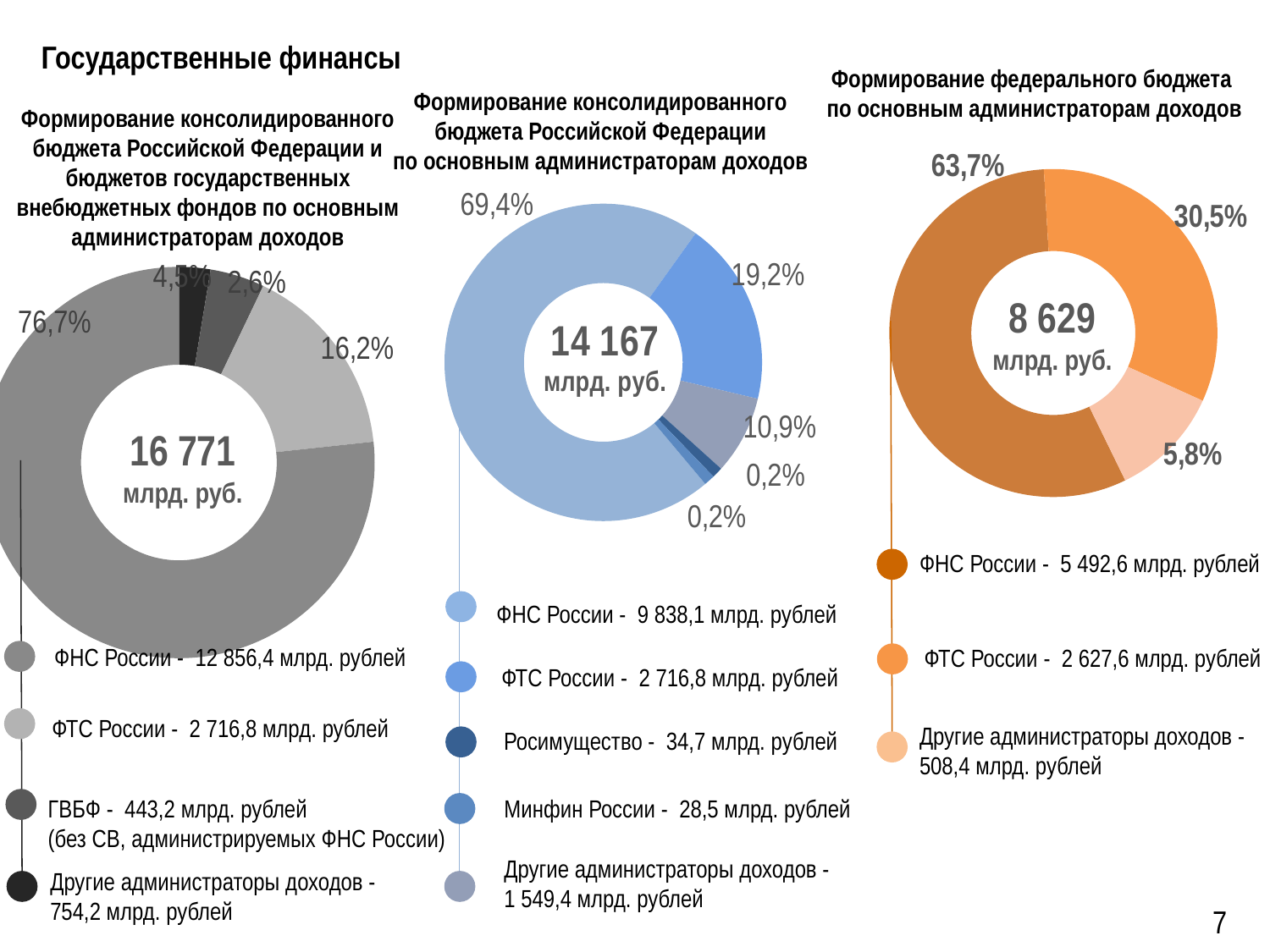
In the chart 'Формирование федерального бюджета по основным администраторам доходов', what value is shown for ФНС России? 5 492,6 млрд. рублей In the middle chart 'Формирование консолидированного бюджета Российской Федерации по основным администраторам доходов', what value is shown for Росимущество? 34,7 млрд. рублей What kind of chart is used for 'Формирование федерального бюджета по основным администраторам доходов'? Pie (donut) chart In the chart 'Формирование федерального бюджета по основным администраторам доходов', what is the difference between the values for ФНС России and ФТС России? 2 865,0 млрд. рублей In the middle chart 'Формирование консолидированного бюджета Российской Федерации по основным администраторам доходов', which administrator has the smallest value? Минфин России In the chart 'Формирование федерального бюджета по основным администраторам доходов', what share of the pie does ФТС России hold? 30,5% In the left chart 'Формирование консолидированного бюджета Российской Федерации и бюджетов государственных внебюджетных фондов по основным администраторам доходов', which is larger: ГВБФ or Другие администраторы доходов? Другие администраторы доходов In the chart 'Формирование федерального бюджета по основным администраторам доходов', what is the total shown in the centre of the donut? 8 629 млрд. руб. In the middle chart 'Формирование консолидированного бюджета Российской Федерации по основным администраторам доходов', what share of the pie does ФНС России hold? 69,4% In the left chart 'Формирование консолидированного бюджета Российской Федерации и бюджетов государственных внебюджетных фондов по основным администраторам доходов', what value is shown for ГВБФ? 443,2 млрд. рублей In the left chart 'Формирование консолидированного бюджета Российской Федерации и бюджетов государственных внебюджетных фондов по основным администраторам доходов', which administrator has the largest value? ФНС России How many categories does the legend of the middle chart 'Формирование консолидированного бюджета Российской Федерации по основным администраторам доходов' list? 5